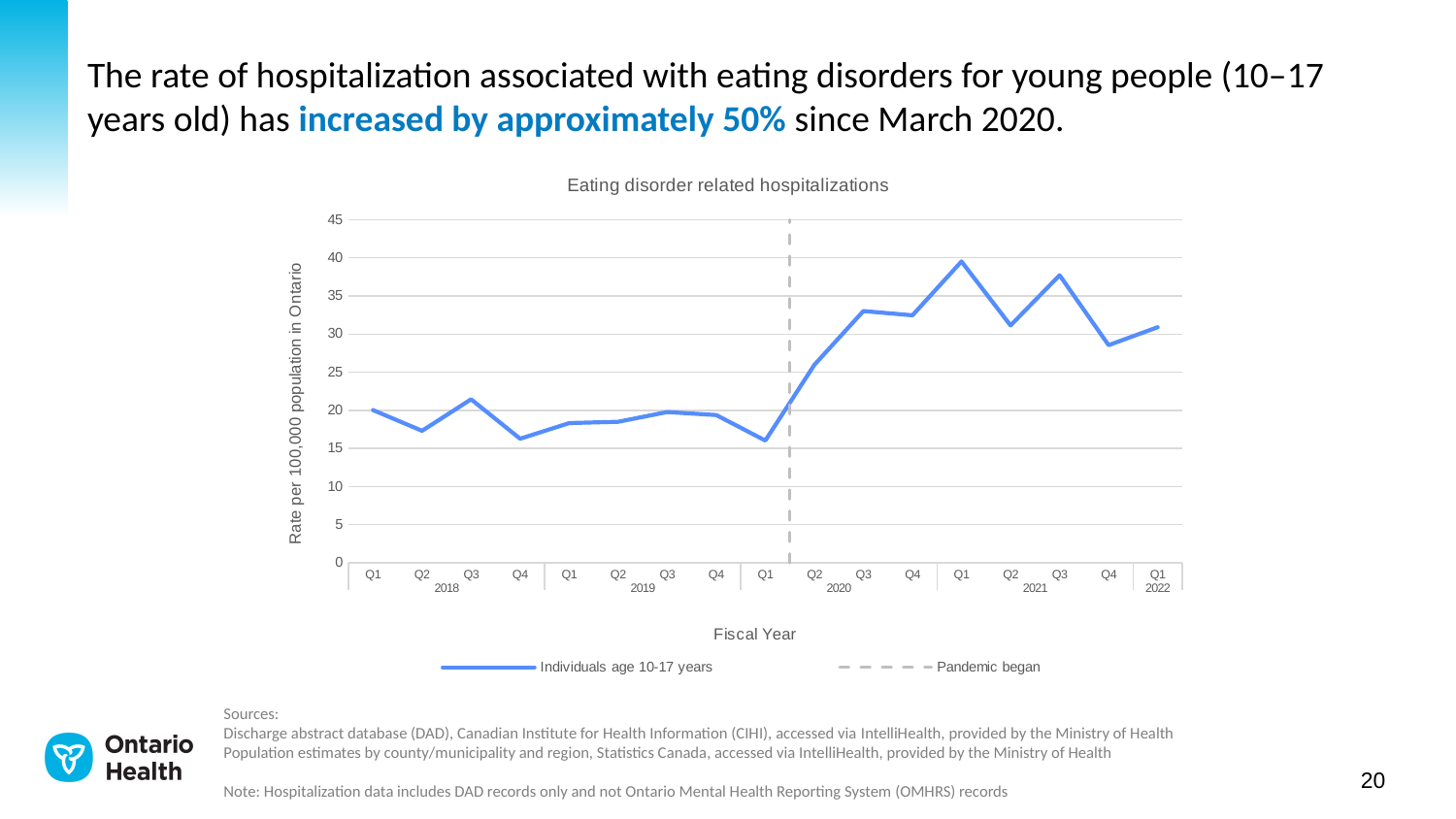
How many entries does the chart's legend list? 2 What is the title of the chart? Eating disorder related hospitalizations Is the value for Q1 2020 greater or less than 20? less How many quarterly data points are plotted on the line? 17 Is the value for Q1 2021 greater or less than 35? greater What kind of chart is shown on the slide? Line chart Is the value for Q3 2020 greater or less than 30? greater Overall, does the hospitalization rate rise or fall from Q1 2018 to Q1 2022? Rise Which is larger, the value for Q3 2019 or the value for Q3 2020? Q3 2020 What is the label on the vertical axis of the chart? Rate per 100,000 population in Ontario Which fiscal quarter has the highest hospitalization rate? Q1 2021